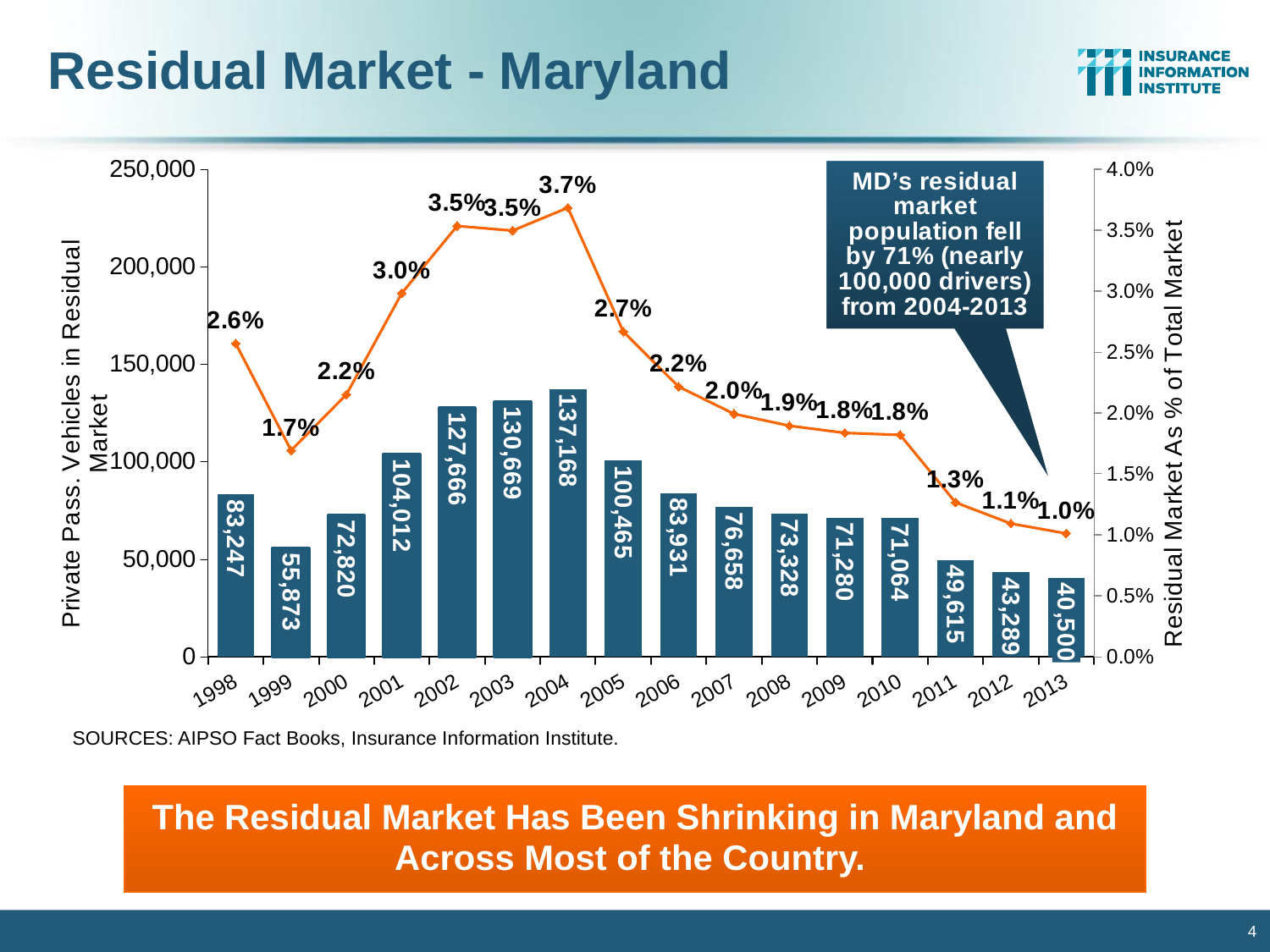
What is the number of private passenger vehicles in the Maryland residual market in 2004? 137,168 What is the number of private passenger vehicles in the residual market in 2013? 40,500 What was the residual market as a percentage of the total market in 2001? 3.0% From 2004 to 2013, do the bar values rise or fall? Fall Which year has the lowest number of private passenger vehicles in the residual market? 2013 Which year had more private passenger vehicles in the residual market, 2001 or 2005? 2001 What is the difference between the number of residual market vehicles in 2004 and in 2013? 96,668 What was the residual market as a percentage of the total market in 1999? 1.7% What is the highest residual market share of the total market shown on the line? 3.7% How many years are shown on the x axis of the chart? 16 Which year has the highest number of private passenger vehicles in the residual market? 2004 What kind of chart is shown on the slide? Combined bar and line chart